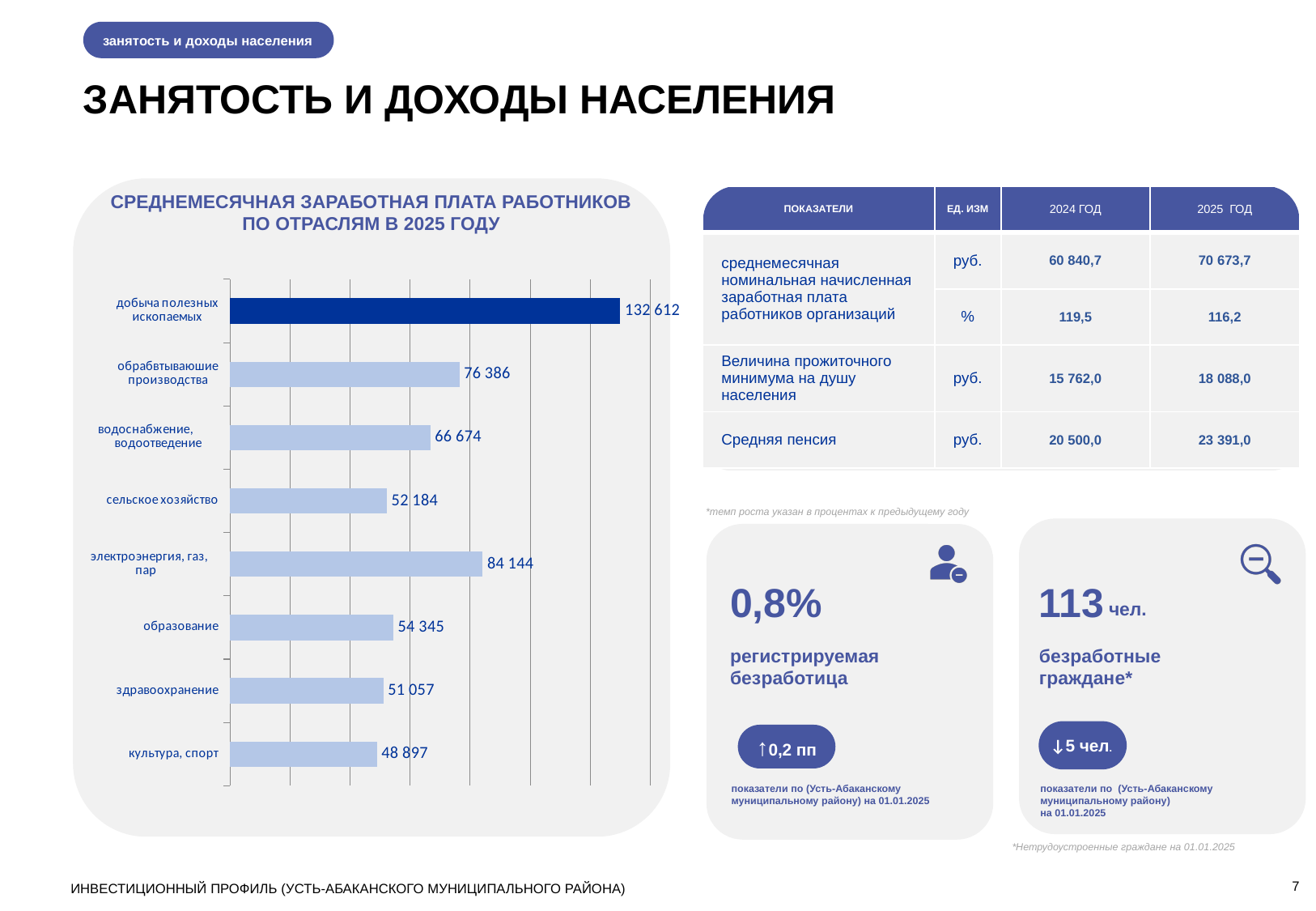
Which industry has the lowest average monthly salary in the chart? культура, спорт What is the value for электроэнергия, газ, пар in the chart? 84 144 What is the difference between the values for добыча полезных ископаемых and обрабатывающие производства? 56 226 What is the average monthly salary for добыча полезных ископаемых in the chart? 132 612 Which is larger: the value for образование or the value for здравоохранение? образование Which bar in the chart is drawn in a darker blue than the others? добыча полезных ископаемых Which industry has the highest average monthly salary in the chart? добыча полезных ископаемых What is the value for культура, спорт in the chart? 48 897 How many industries are shown in the chart? 8 What is the value for обрабатывающие производства in the chart? 76 386 What type of chart is shown on the slide? bar chart What is the difference between the values for электроэнергия, газ, пар and водоснабжение, водоотведение? 17 470